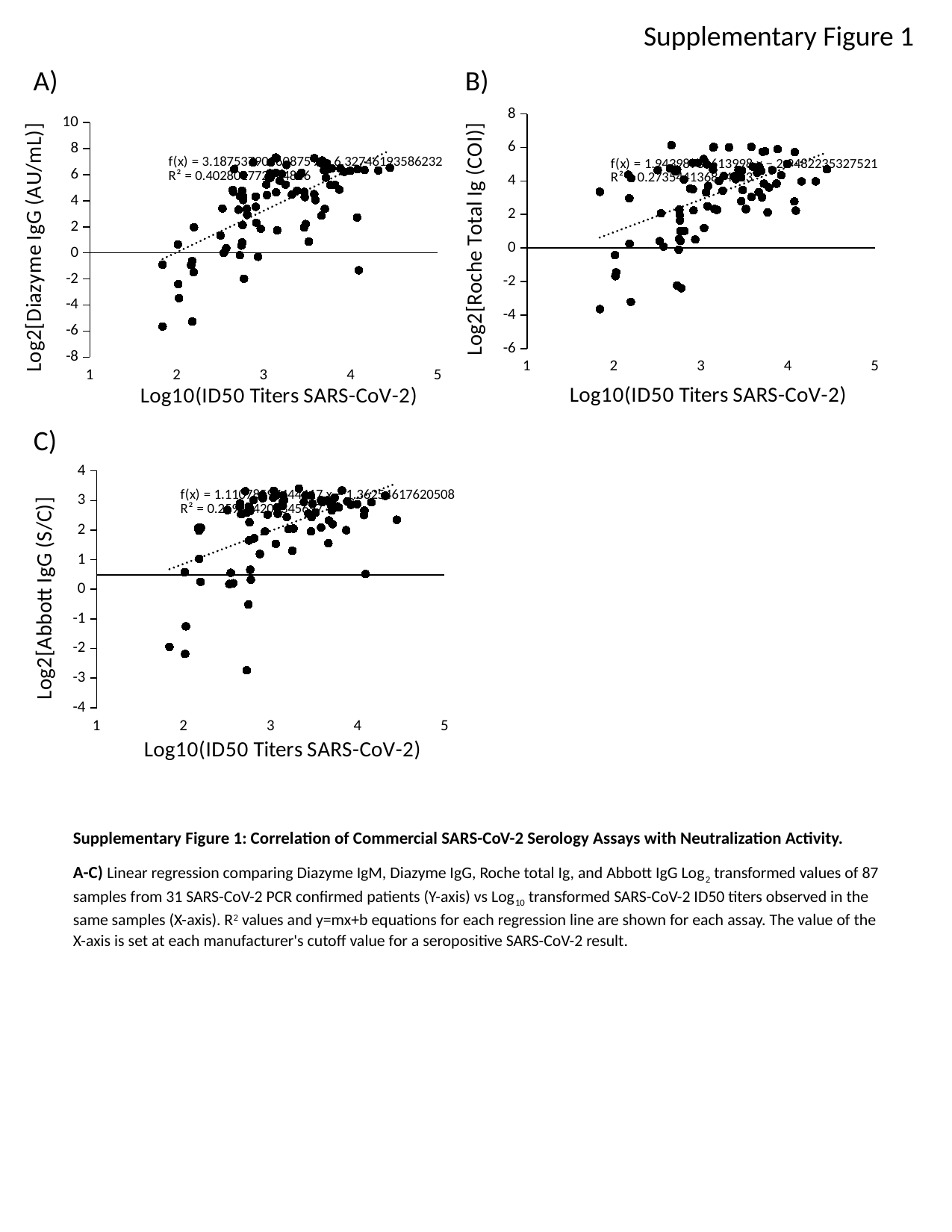
What is the x-axis title of chart B (the top-right chart)? Log10(ID50 Titers SARS-CoV-2) In chart A (Log2[Diazyme IgG (AU/mL)]), do the plotted values generally rise or fall as Log10(ID50 Titers SARS-CoV-2) increases? rise What kind of chart is chart A (Log2[Diazyme IgG (AU/mL)])? scatter chart What kind of chart is chart C (Log2[Abbott IgG (S/C)])? scatter chart What kind of chart is chart B (Log2[Roche Total Ig (COI)])? scatter chart In chart B (Log2[Roche Total Ig (COI)]), do the plotted values generally rise or fall as Log10(ID50 Titers SARS-CoV-2) increases? rise In chart C (Log2[Abbott IgG (S/C)]), do the plotted values generally rise or fall as Log10(ID50 Titers SARS-CoV-2) increases? rise What is the y-axis title of chart C (the bottom-left chart)? Log2[Abbott IgG (S/C)]